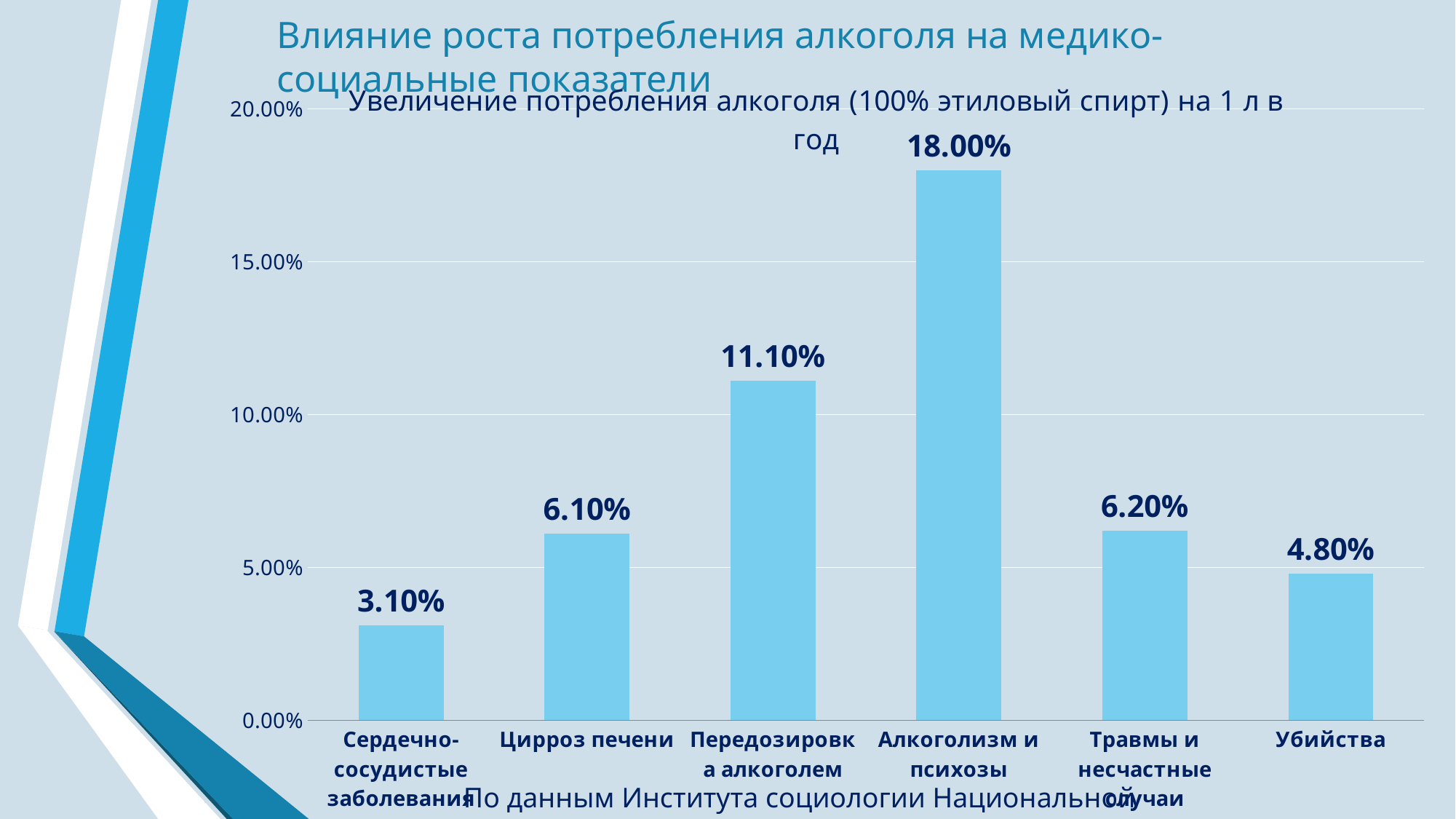
How many categories are shown on the x axis? 6 Is the value for Травмы и несчастные случаи greater or less than 5.00%? greater Which category has the lowest value? Сердечно-сосудистые заболевания Which is larger, the value for Цирроз печени or the value for Убийства? Цирроз печени What is the value for Сердечно-сосудистые заболевания? 3.10% What is the value for Убийства? 4.80% Which category has the highest value? Алкоголизм и психозы What is the value for Алкоголизм и психозы? 18.00% What is the difference between the values for Алкоголизм и психозы and Передозировка алкоголем? 6.90% What is the value for Передозировка алкоголем? 11.10% What type of chart is shown on the slide? bar chart What is the title of the chart? Увеличение потребления алкоголя (100% этиловый спирт) на 1 л в год